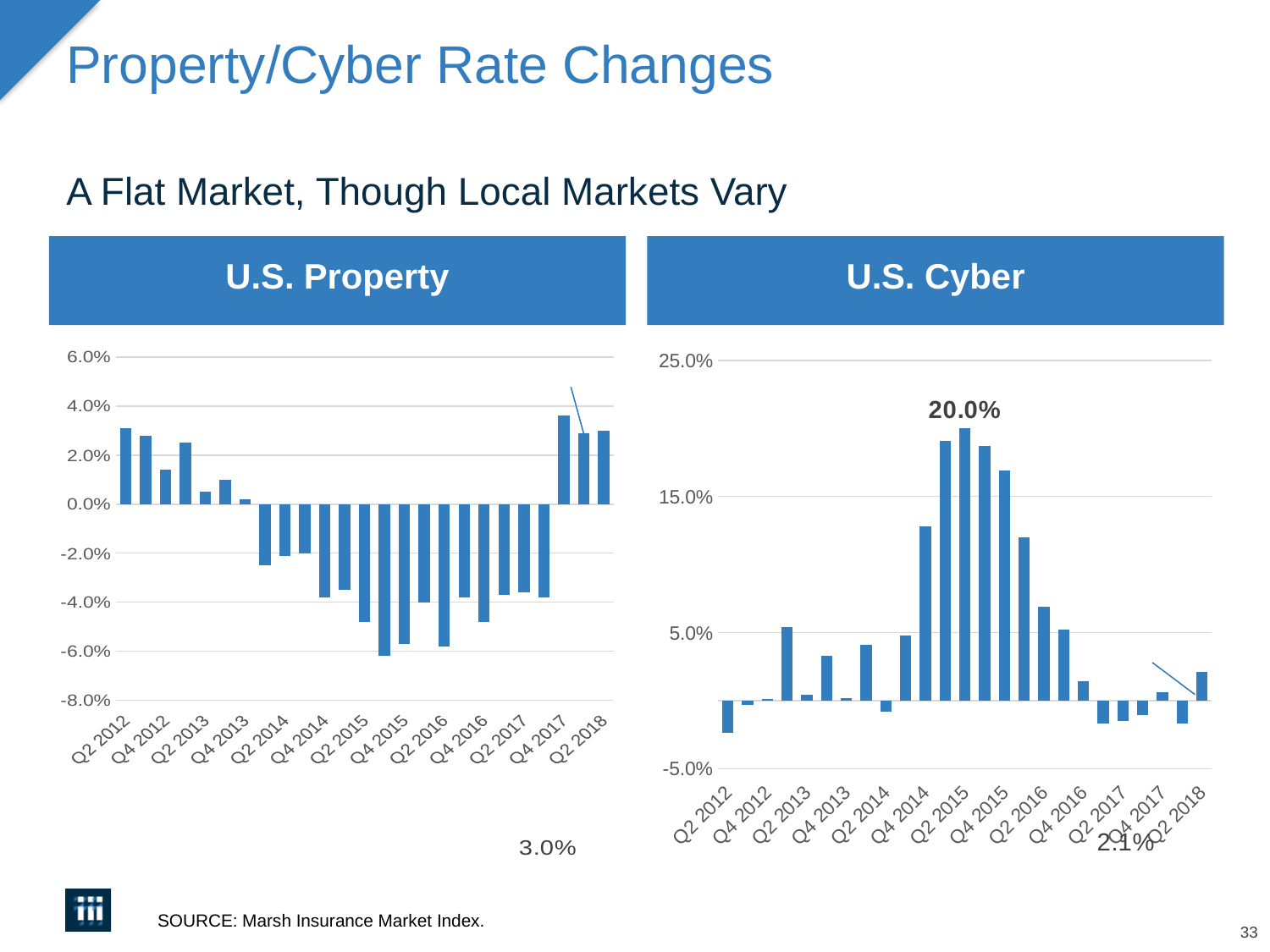
In the U.S. Cyber chart, what is the highest value labeled? 20.0% In the U.S. Property chart, is the value for Q2 2012 greater or less than 2.0%? greater In the U.S. Cyber chart, which is larger: the value for Q2 2012 or the value for Q2 2018? Q2 2018 What source is cited for the charts? Marsh Insurance Market Index In the U.S. Cyber chart, is the value for Q2 2018 greater or less than 5.0%? less In the U.S. Cyber chart, do the values rise or fall from Q2 2015 to Q2 2017? fall How many charts are shown on the slide? 2 In the U.S. Property chart, is the value for Q2 2016 greater or less than 0.0%? less What type of chart is the U.S. Property chart? bar chart In the U.S. Cyber chart, what is the rate change for Q2 2018? 2.1% What is the title of the chart on the left? U.S. Property